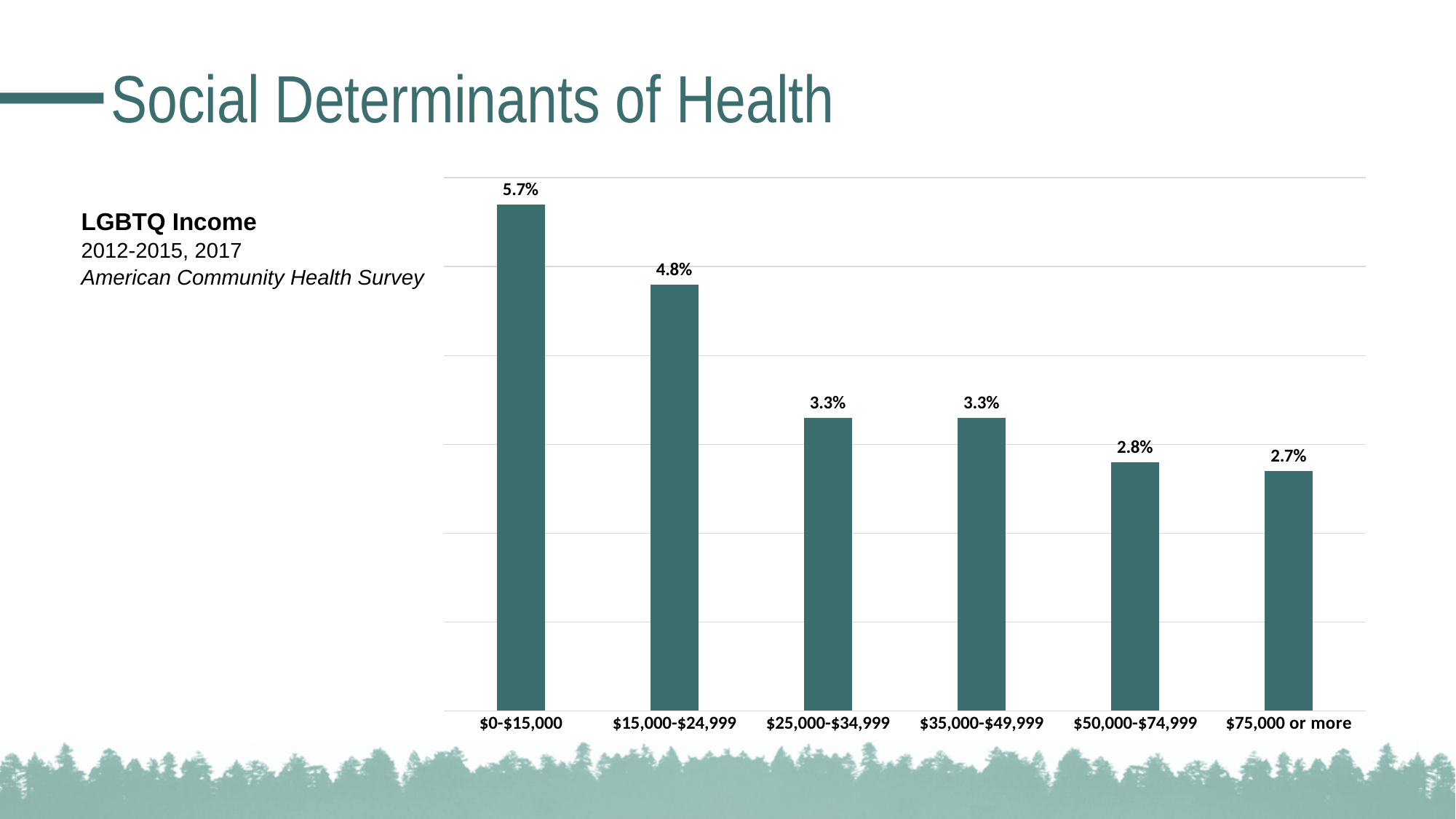
What is the value for the $15,000-$24,999 income category? 4.8% What kind of chart is shown on the slide? Bar chart What is the value for the $0-$15,000 income category? 5.7% What is the difference between the values for $0-$15,000 and $15,000-$24,999? 0.9% Which income category has the highest value? $0-$15,000 What is the difference between the values for $25,000-$34,999 and $75,000 or more? 0.6% Which is larger, the value for $15,000-$24,999 or the value for $35,000-$49,999? $15,000-$24,999 What is the value for the $75,000 or more income category? 2.7% How many income categories are shown in the chart? 6 What is the value for the $50,000-$74,999 income category? 2.8% Which income category has the lowest value? $75,000 or more Do the values rise or fall as income increases along the x axis? Fall